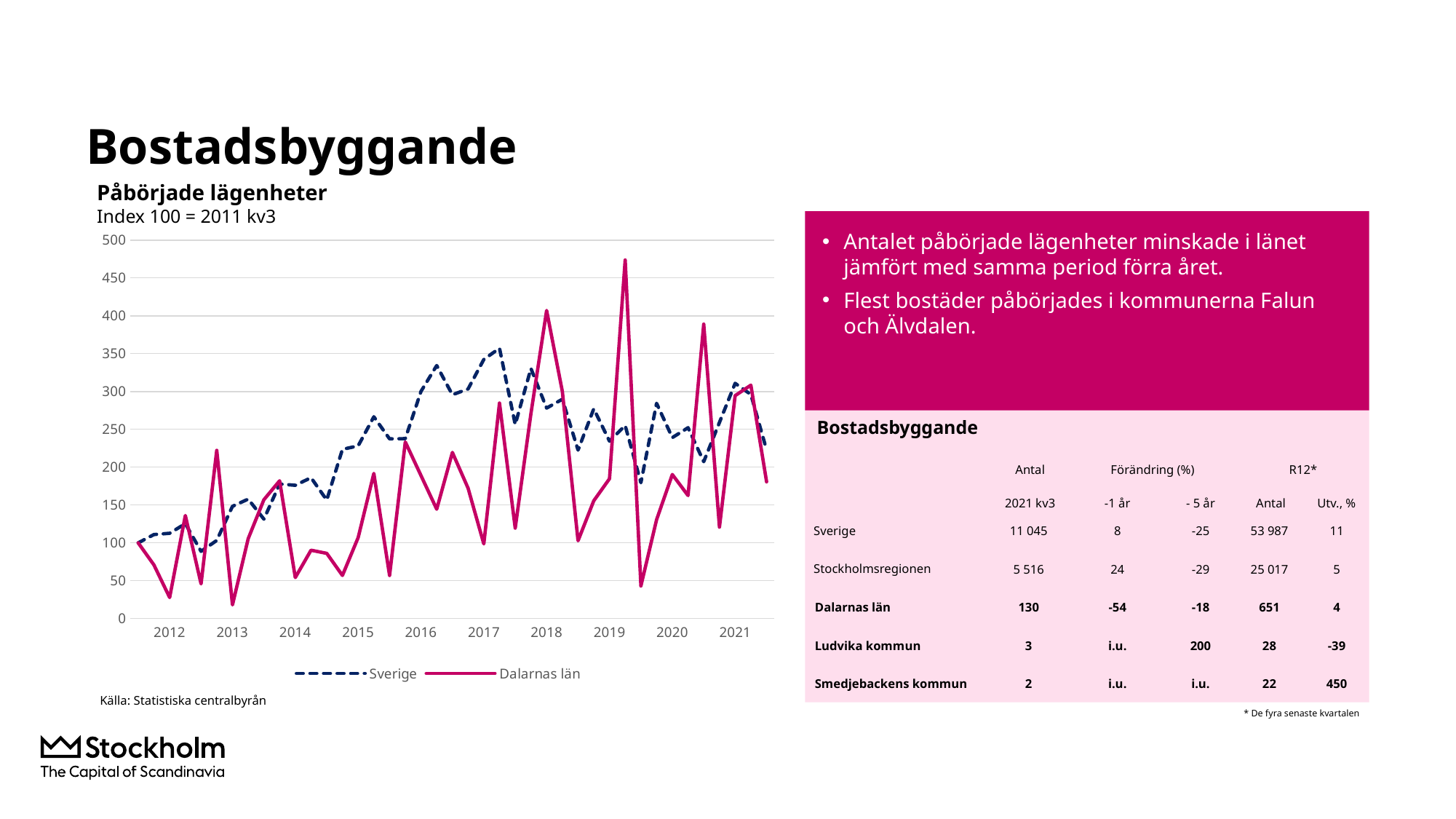
Is the Sverige value at the start of 2017 greater or less than 300? greater Which series reaches the highest peak in the chart? Dalarnas län What is the maximum value shown on the vertical axis of the chart? 500 Does the Sverige series generally rise or fall from 2012 to 2021? rise Which two series are shown in the chart legend? Sverige and Dalarnas län How many series does the chart legend list? 2 What kind of chart is shown on the slide? Line chart Is the highest peak of the Dalarnas län series (around 2019) greater or less than 450? greater Is the lowest value of the Dalarnas län series (around 2013) greater or less than 50? less What is the title of the chart? Påbörjade lägenheter